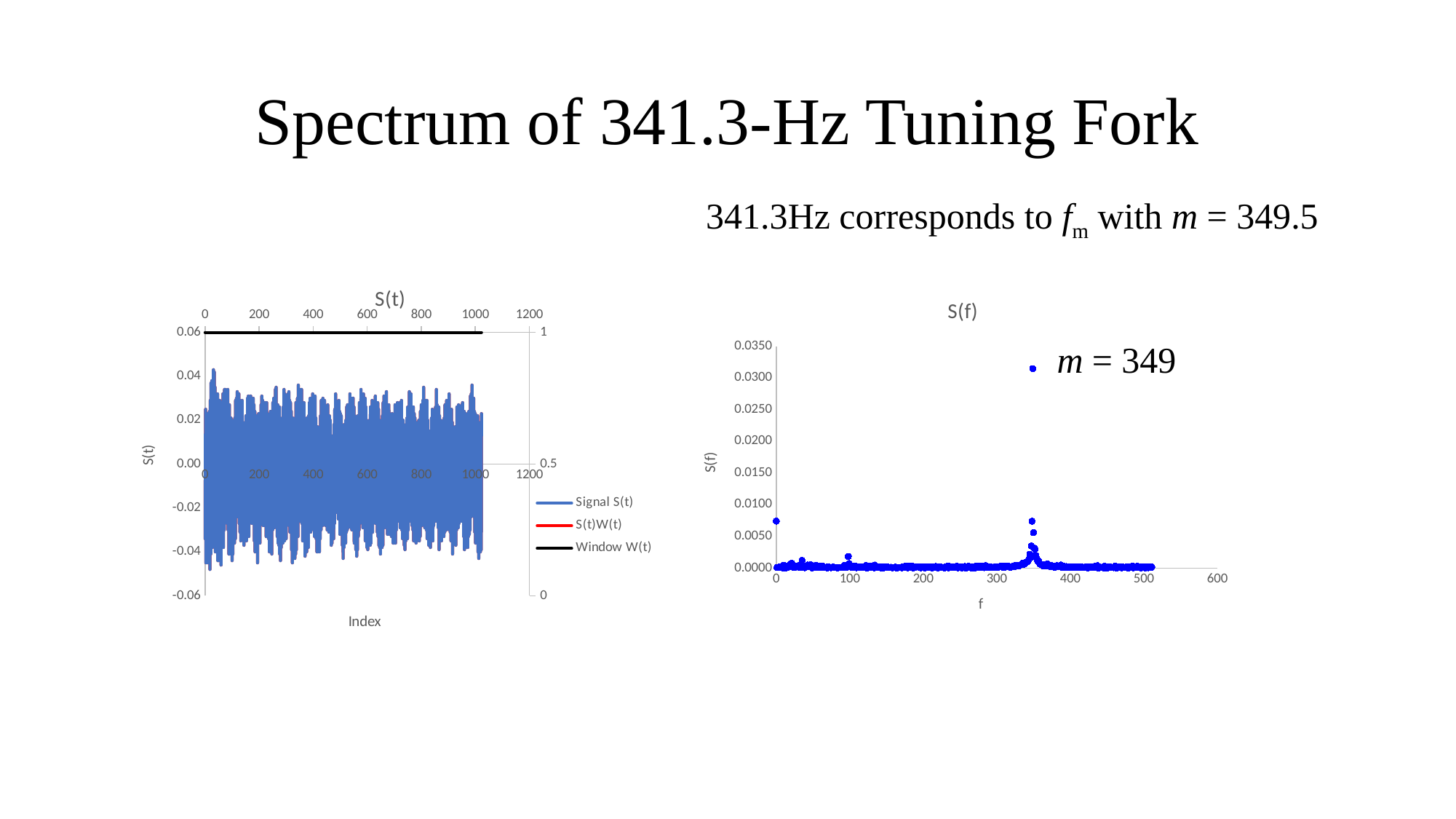
In the S(f) chart, is the highest value of the peak near f = 350 greater or less than 0.0050? greater What kind of chart is the chart titled S(f) on the right of the slide? scatter chart In the S(f) chart, is the highest value of the peak near f = 350 greater or less than 0.0100? less In the S(f) chart, around which f value does the largest peak occur: near 100 or near 350? near 350 In the S(t) chart, what value does the Window W(t) series hold on the right-hand axis? 1 How many series does the legend of the S(t) chart list? 3 In the S(f) chart, is the value of the small peak near f = 100 greater or less than 0.0050? less What is the x-axis label of the S(t) chart? Index What is the x-axis label of the S(f) chart? f What is the legend entry shown on the S(f) chart? m = 349 What kind of chart is the chart titled S(t) on the left of the slide? line chart